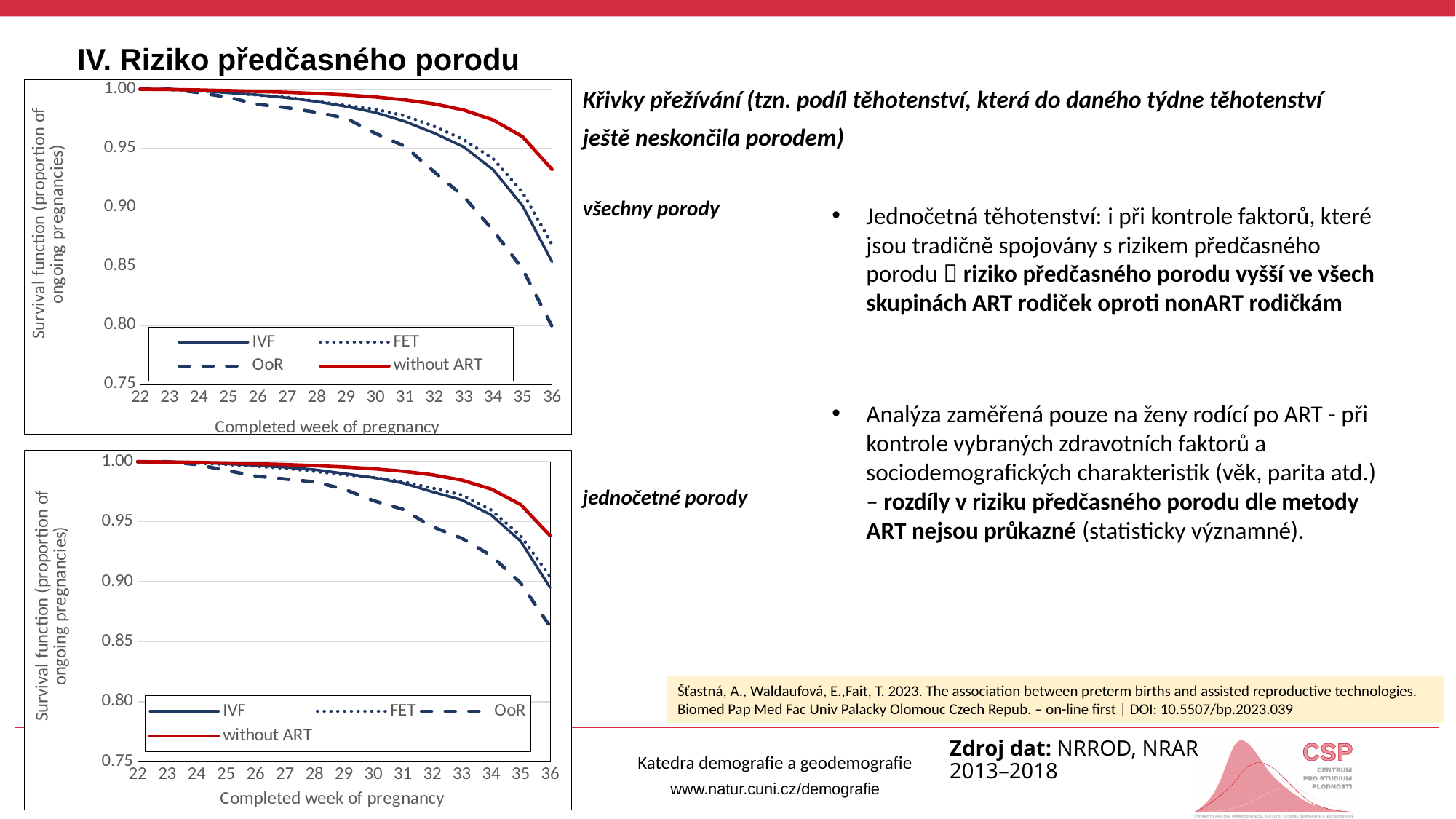
In the top chart (všechny porody), which series has the highest value at week 36? without ART In the top chart (všechny porody), is the value for without ART at week 36 greater or less than 0.90? greater In the top chart (všechny porody), is the value for OoR at week 36 greater or less than 0.85? less In the bottom chart (jednočetné porody), is the value for OoR at week 36 greater or less than 0.90? less In the top chart (všechny porody), do the survival function values rise or fall as the completed week of pregnancy increases? fall How many series does the legend of the top chart (všechny porody) list? 4 How many completed weeks of pregnancy are shown on the x axis of the bottom chart (jednočetné porody)? 15 In the bottom chart (jednočetné porody), which is larger at week 36: the value for without ART or the value for OoR? without ART In the top chart (všechny porody), which series is drawn in red? without ART What type of chart is the top chart (všechny porody)? line chart In the bottom chart (jednočetné porody), which series has the lowest value at week 36? OoR In the top chart (všechny porody), which series has the lowest value at week 36? OoR